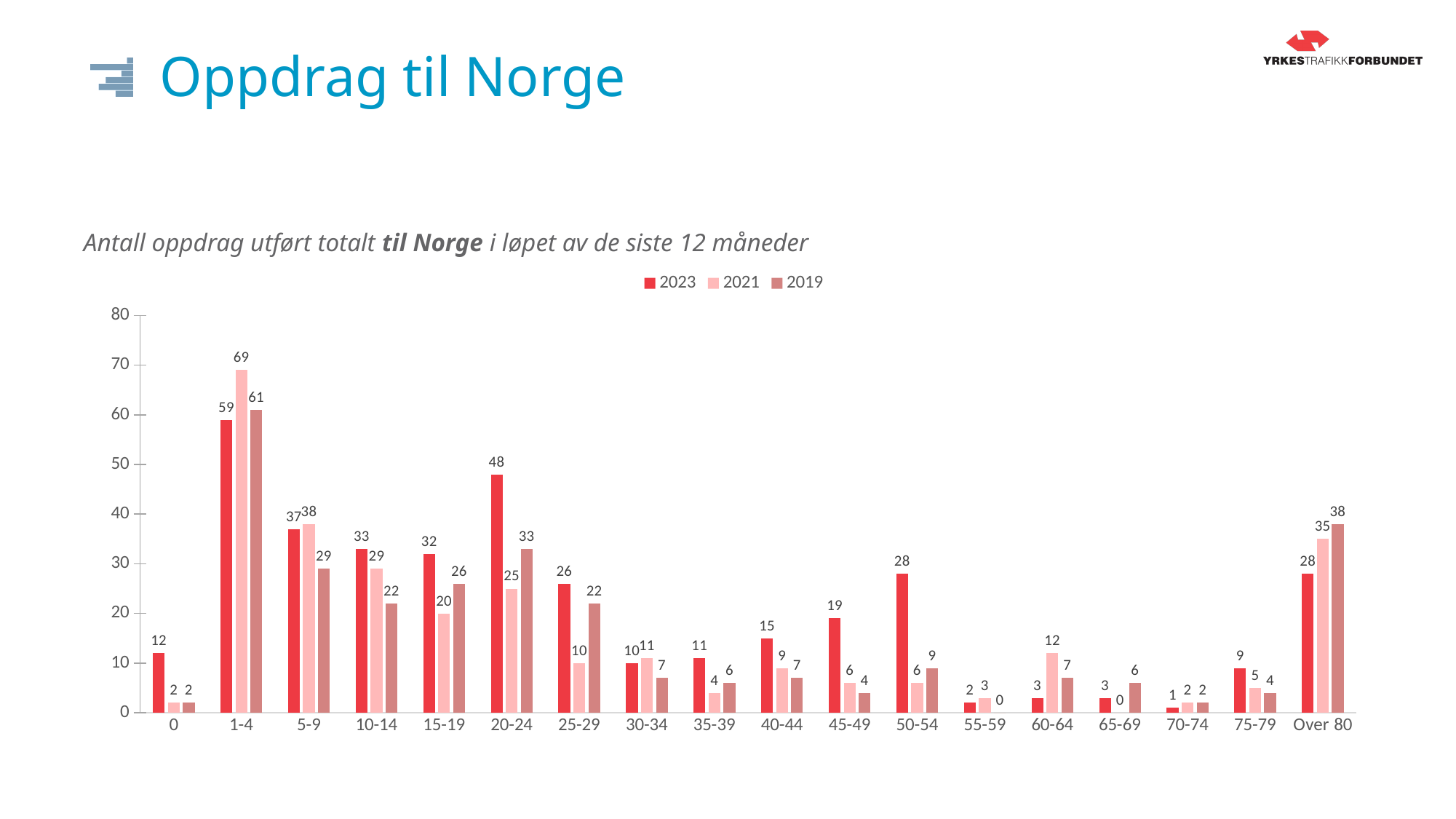
Is the 2019 value for the 1-4 category greater or less than 50? greater What is the value for 2021 in the 1-4 category? 69 What is the value for 2019 in the Over 80 category? 38 Which is larger in the 60-64 category, the 2023 value or the 2021 value? 2021 What is the value for 2023 in the 20-24 category? 48 How many series does the legend list? 3 What kind of chart is shown on the slide? bar chart Which category has the lowest value for the 2023 series? 70-74 What is the difference between the 2023 and 2021 values in the 20-24 category? 23 Which series is shown in the lightest pink colour in the legend? 2021 How many categories are shown on the x axis? 18 Which category has the highest value for the 2023 series? 1-4